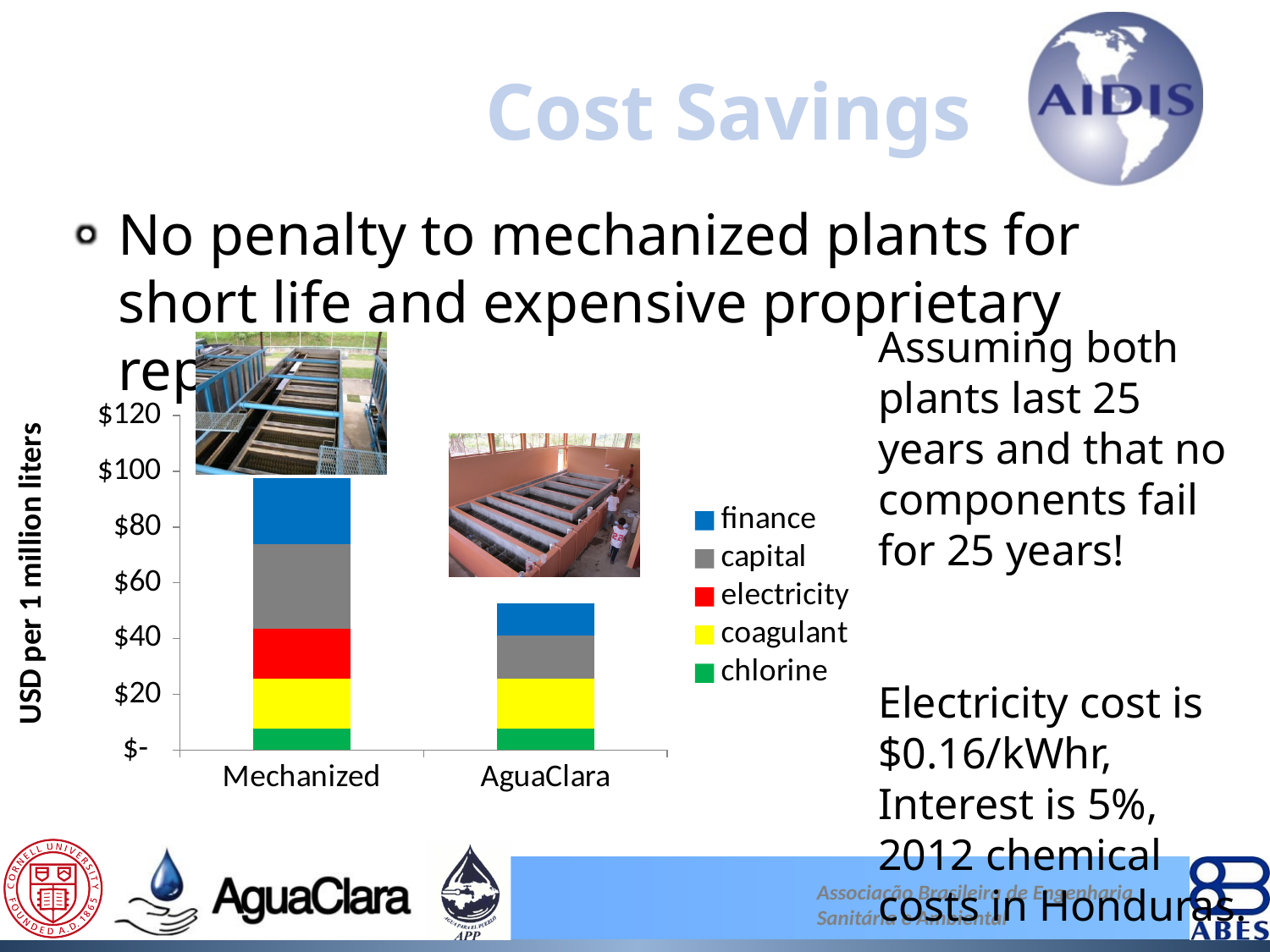
Which category has the taller stacked bar, Mechanized or AguaClara? Mechanized Which category has the highest total cost in the chart? Mechanized How many categories are shown on the x axis of the chart? 2 Is the total value for Mechanized greater or less than $120? less How many series does the chart's legend list? 5 Is the total value for AguaClara greater or less than $40? greater Which legend series is shown in red in the chart? electricity What is the label on the vertical axis of the chart? USD per 1 million liters Is the total value for AguaClara greater or less than $60? less Which category has the lowest total cost in the chart? AguaClara What kind of chart is shown on the slide? stacked bar chart